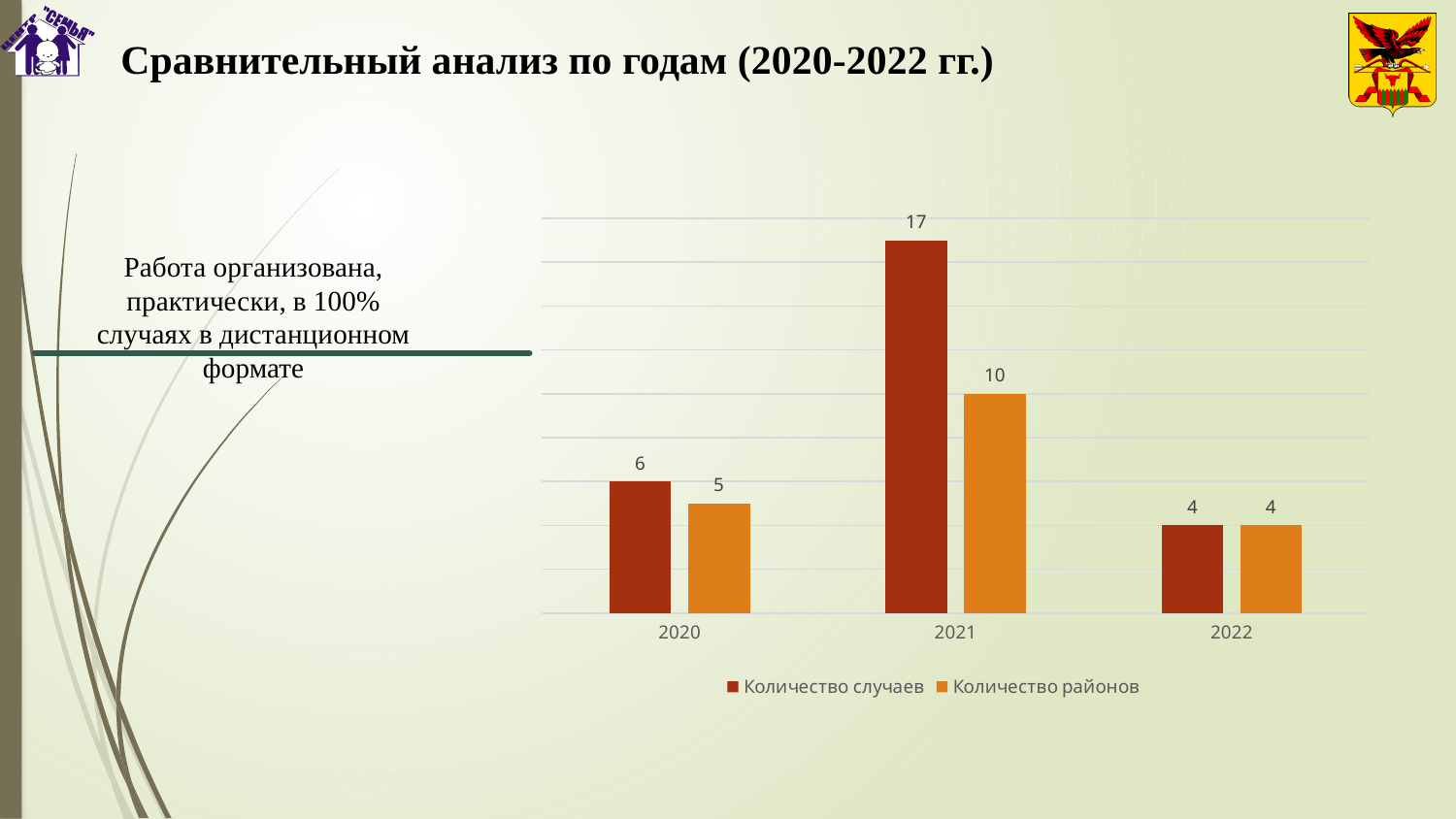
What is the difference between Количество случаев and Количество районов in 2021? 7 Does Количество случаев rise or fall from 2021 to 2022? Fall What is the value of Количество районов for 2022? 4 What is the title of the slide containing the chart? Сравнительный анализ по годам (2020-2022 гг.) What is the value of Количество районов for 2020? 5 What kind of chart is shown on the slide? Bar chart Which year has the highest value for Количество случаев? 2021 Which year has the lowest value for Количество районов? 2022 How many years are shown on the x axis? 3 How many series does the legend list? 2 Which is larger in 2020: Количество случаев or Количество районов? Количество случаев What is the value of Количество случаев for 2021? 17